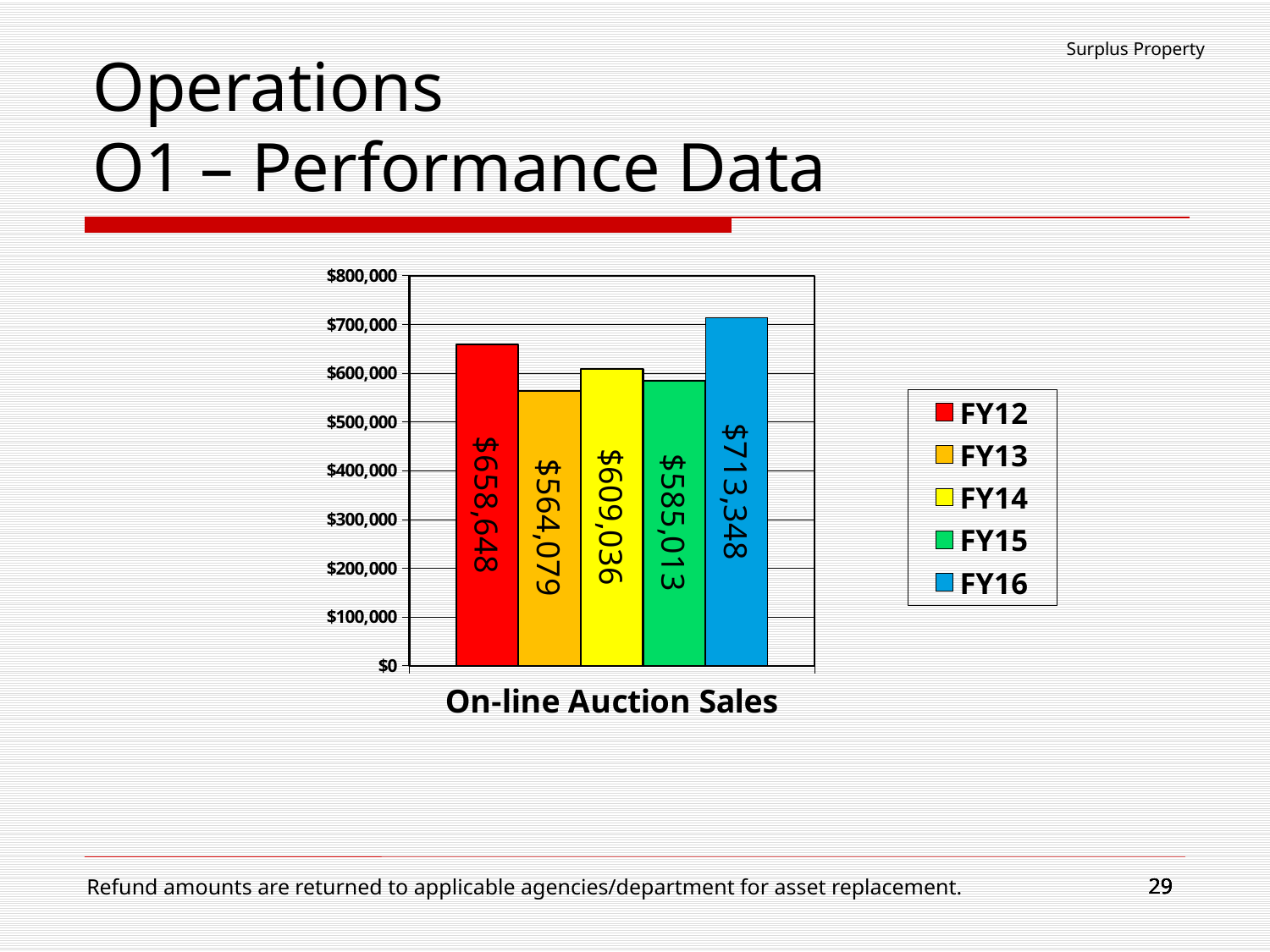
What is the On-line Auction Sales value for FY14? $609,036 What is the On-line Auction Sales value for FY12? $658,648 Is the On-line Auction Sales value for FY16 greater or less than $700,000? greater What is the difference between the FY14 and FY13 On-line Auction Sales values? $44,957 What is the difference between the FY16 and FY12 On-line Auction Sales values? $54,700 How many series does the legend list? 5 What is the On-line Auction Sales value for FY16? $713,348 What colour is the FY15 bar in the chart? Green Which fiscal year has the lowest On-line Auction Sales? FY13 What kind of chart is shown on the slide? Bar chart Which is larger, the On-line Auction Sales for FY14 or FY15? FY14 Which fiscal year has the highest On-line Auction Sales? FY16